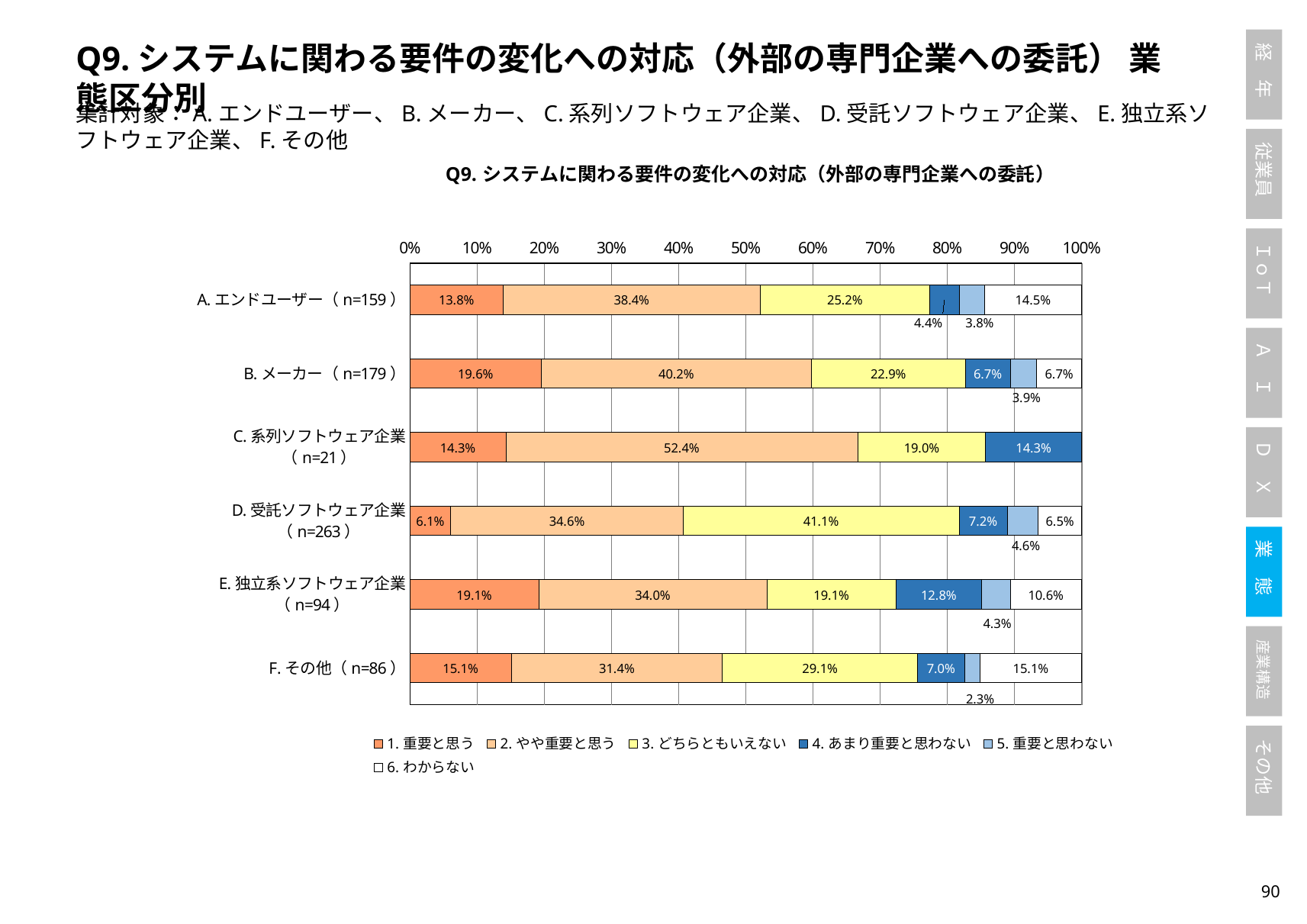
How many categories (business types) are plotted on the chart? 6 What is the difference between the "3. どちらともいえない" values for D. 受託ソフトウェア企業 and E. 独立系ソフトウェア企業? 22.0% How many series does the legend list? 6 Which category has the lowest value for "1. 重要と思う"? D. 受託ソフトウェア企業 What is the sample size (n) shown for D. 受託ソフトウェア企業? 263 Which is larger: the "4. あまり重要と思わない" value for E. 独立系ソフトウェア企業 or for B. メーカー? E. 独立系ソフトウェア企業 Which category has the highest value for "2. やや重要と思う"? C. 系列ソフトウェア企業 What kind of chart is shown on the slide? Stacked bar chart What is the value of "3. どちらともいえない" for D. 受託ソフトウェア企業? 41.1% What is the value of "6. わからない" for A. エンドユーザー? 14.5% What is the value of "1. 重要と思う" for B. メーカー? 19.6% What is the value of "2. やや重要と思う" for C. 系列ソフトウェア企業? 52.4%